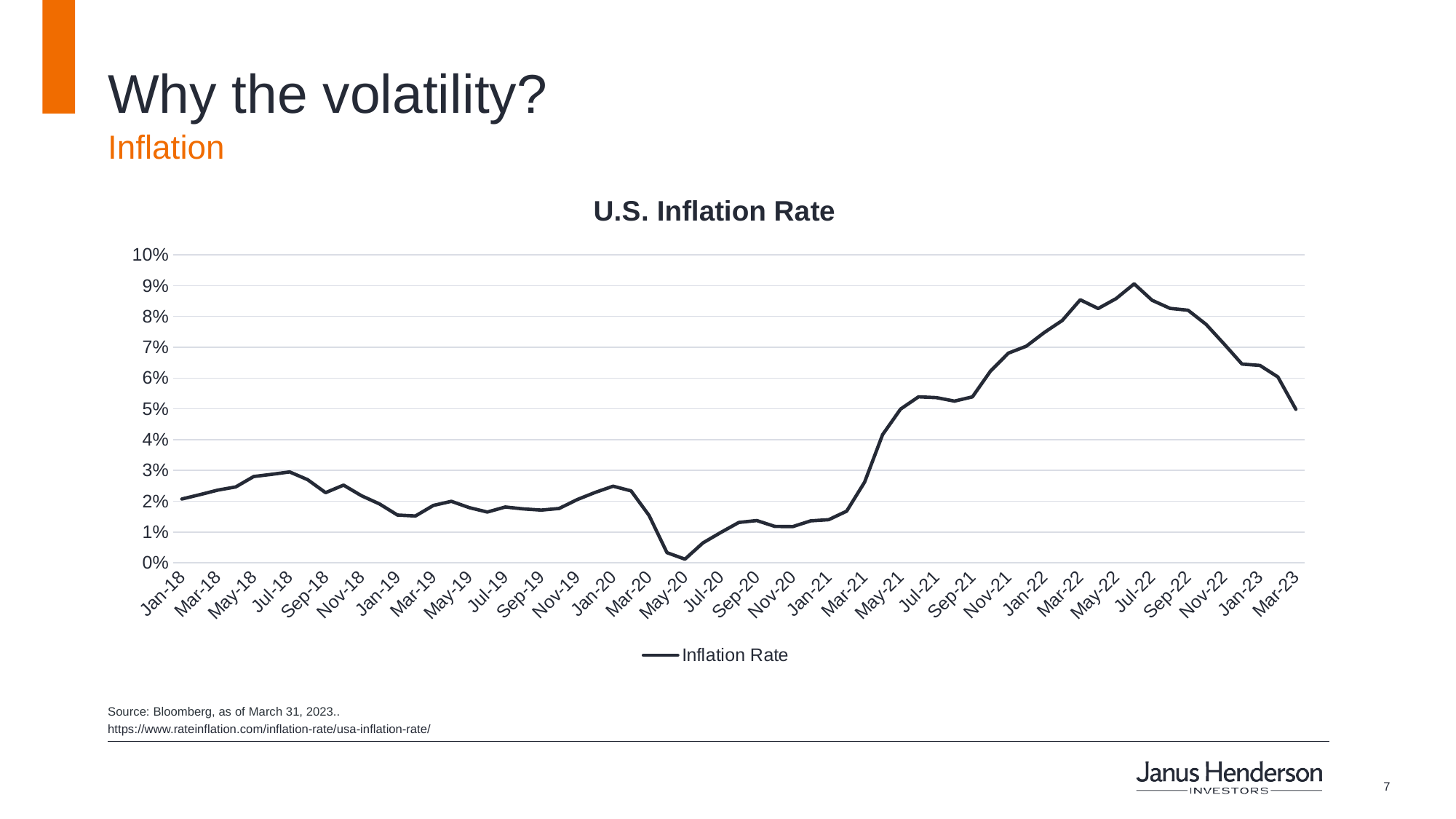
How many series does the legend list? 1 Around which month does the inflation rate reach its lowest point? May-20 Does the inflation rate rise or fall between Jul-22 and Mar-23? fall What is the name of the series shown in the legend? Inflation Rate Is the value for Jan-18 greater or less than 3%? less Is the value for Jul-22 greater or less than 8%? greater Which is larger, the inflation rate in Jul-22 or in Jan-18? Jul-22 What is the title of the chart? U.S. Inflation Rate What kind of chart is shown on the slide? line chart Is the value for Jan-23 greater or less than 6%? greater Around which month does the inflation rate reach its highest point? Jun-22